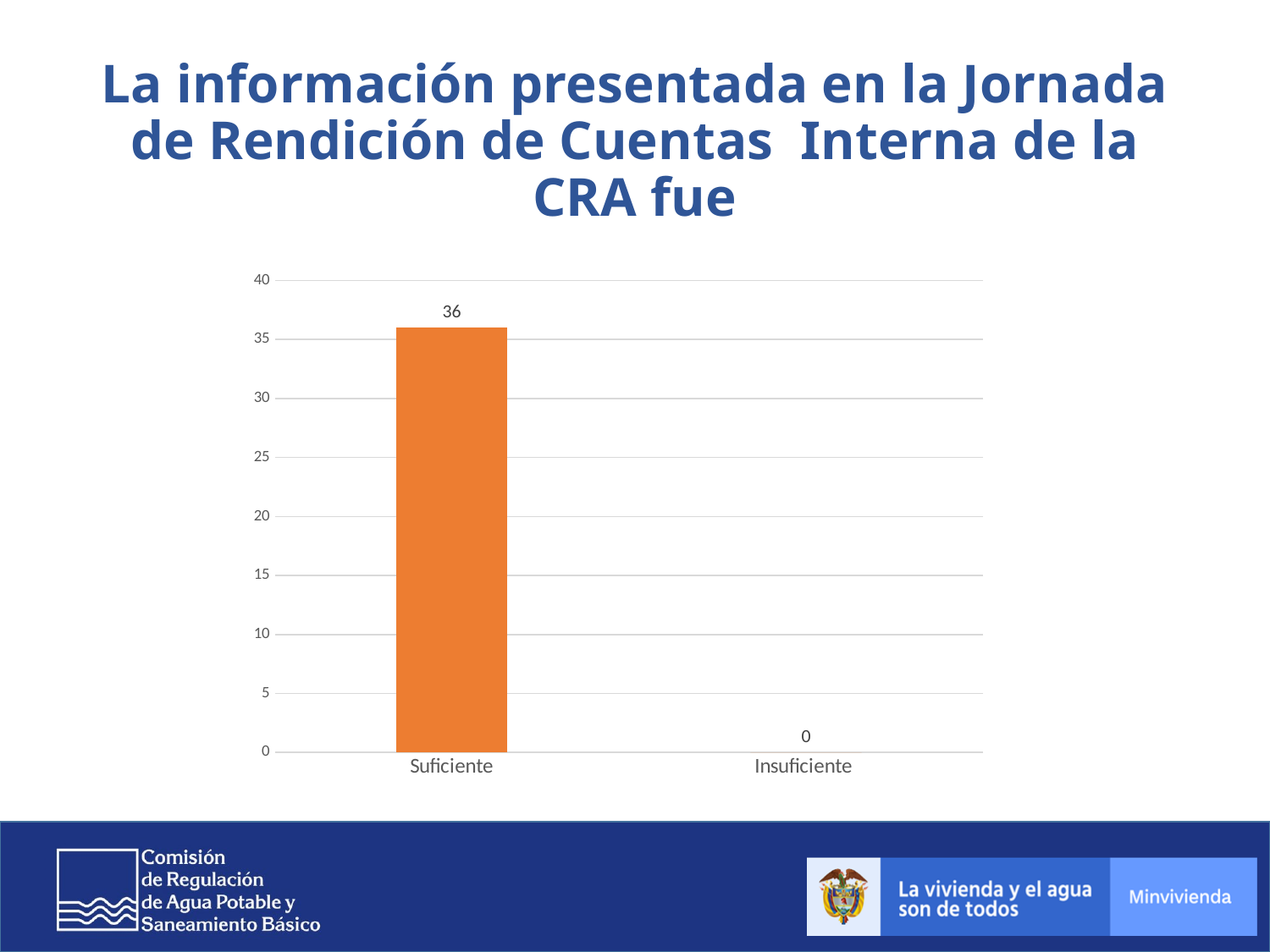
What colour is the bar for Suficiente? orange What is the value for Suficiente? 36 How many categories are shown on the x axis? 2 Is the value for Suficiente greater or less than 35? greater Which is larger, the value for Suficiente or the value for Insuficiente? Suficiente What kind of chart is shown on the slide? bar chart Which category has the lowest value? Insuficiente What is the value for Insuficiente? 0 What is the difference between the values for Suficiente and Insuficiente? 36 Which category has the highest value? Suficiente What is the total of the values for Suficiente and Insuficiente? 36 Is the value for Suficiente greater or less than 40? less